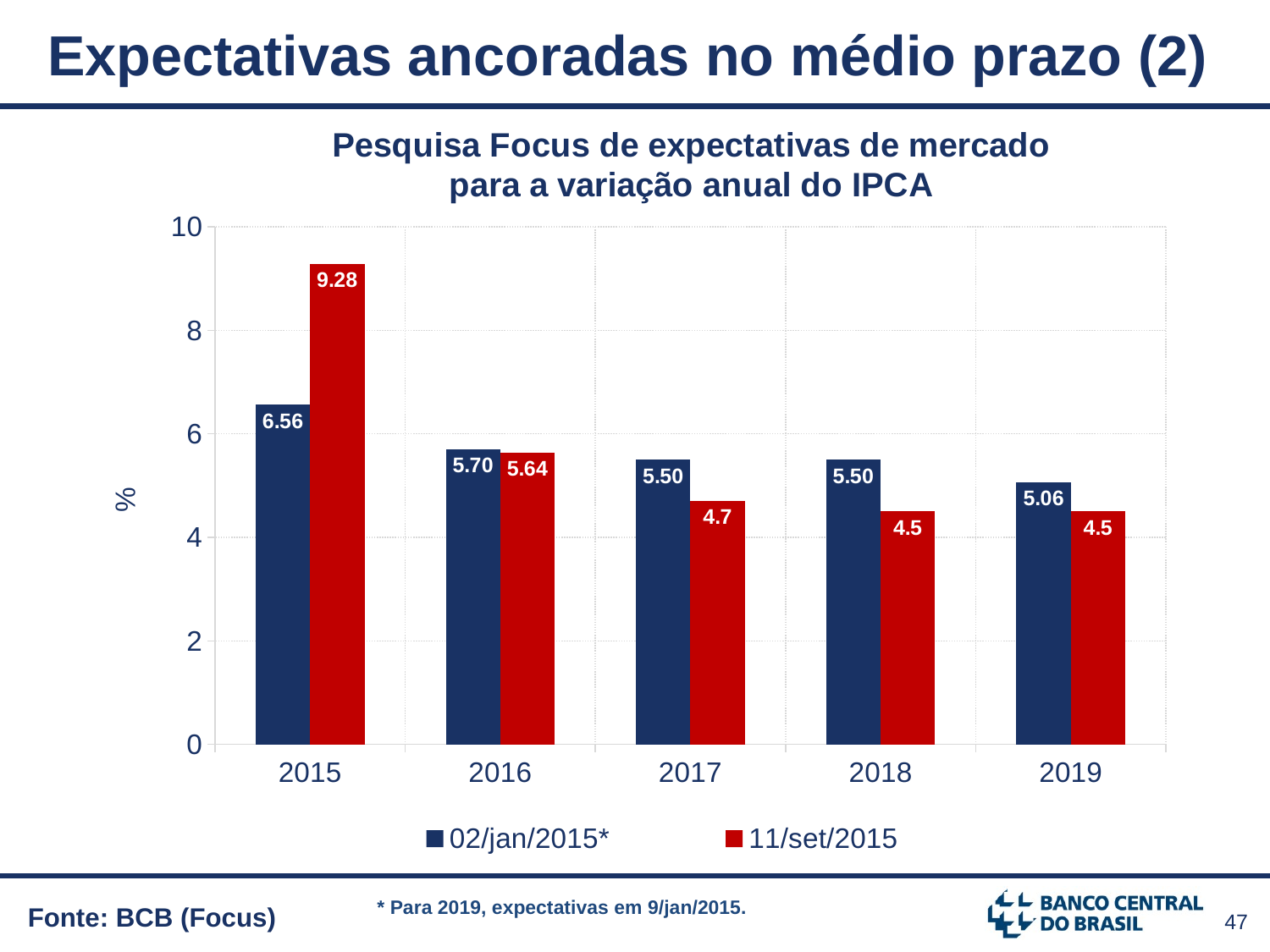
How many years are shown on the x axis? 5 Is the value for 2015 in the 11/set/2015 series greater or less than 8? greater What is the value for 2017 in the 11/set/2015 series? 4.7 What kind of chart is shown on the slide? bar chart Which year has the lowest value in the 02/jan/2015* series? 2019 What is the value for 2019 in the 02/jan/2015* series? 5.06 Do the values in the 11/set/2015 series rise or fall from 2015 to 2019? fall For 2018, which series has the larger value, 02/jan/2015* or 11/set/2015? 02/jan/2015* Which year has the highest value in the 11/set/2015 series? 2015 How many series does the legend list? 2 What is the value for 2015 in the 11/set/2015 series? 9.28 What is the difference between the 11/set/2015 and 02/jan/2015* values for 2015? 2.72